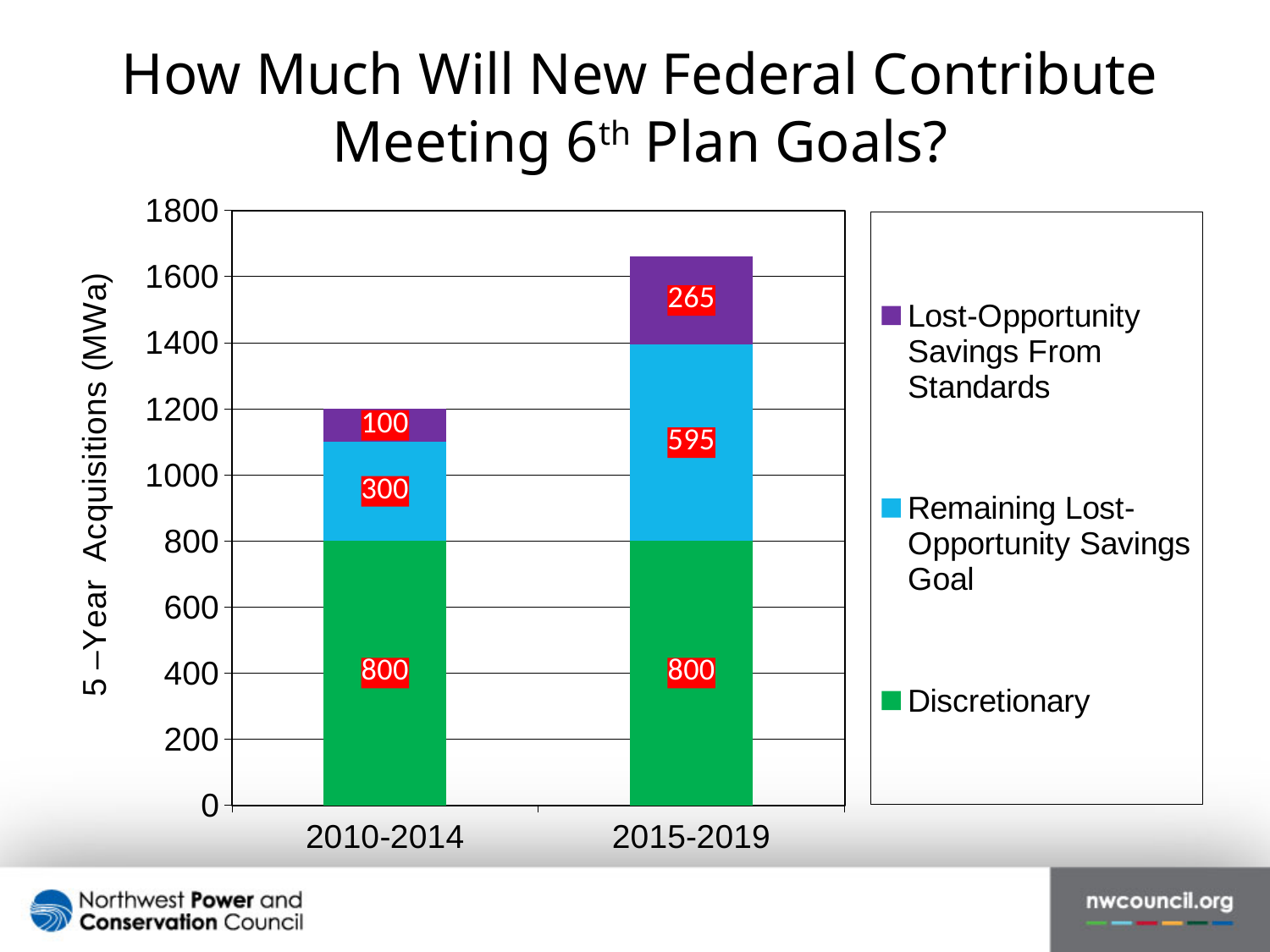
What is the total of the stacked bar for 2010-2014? 1200 What is the Lost-Opportunity Savings From Standards value for 2015-2019? 265 What is the Remaining Lost-Opportunity Savings Goal value for 2015-2019? 595 How many periods are shown on the x axis? 2 What is the Discretionary value for 2010-2014? 800 How many series does the legend list? 3 What is the Lost-Opportunity Savings From Standards value for 2010-2014? 100 What is the label of the y axis? 5 –Year Acquisitions (MWa) What kind of chart is shown on the slide? Stacked bar chart What is the difference between the Remaining Lost-Opportunity Savings Goal values for 2015-2019 and 2010-2014? 295 Which period has the larger Lost-Opportunity Savings From Standards value, 2010-2014 or 2015-2019? 2015-2019 What is the total of the stacked bar for 2015-2019? 1660